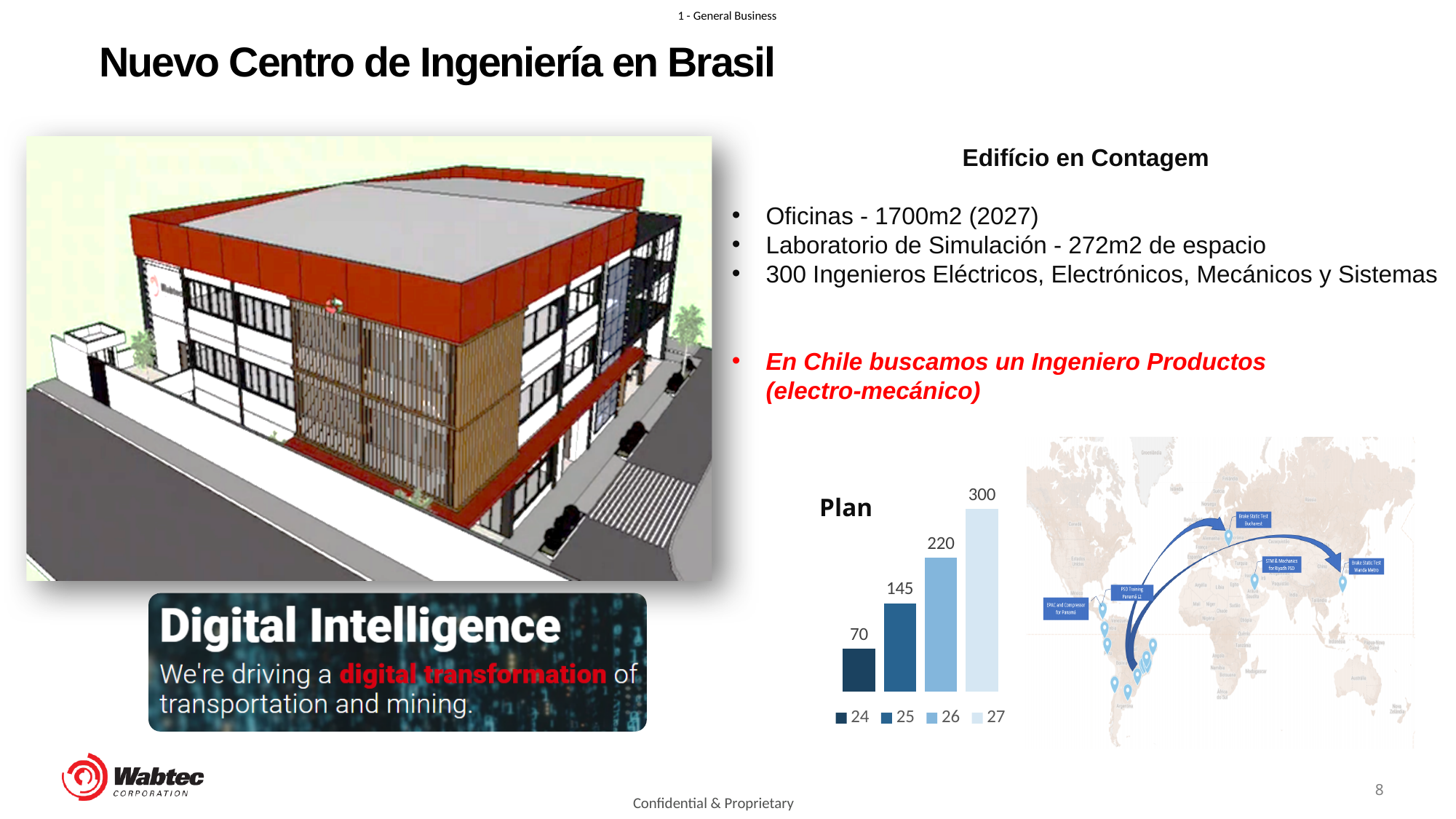
In the "Plan" chart, what is the value for 26? 220 In the "Plan" chart, what is the difference between the values for 27 and 24? 230 In the "Plan" chart, what is the value for 27? 300 In the "Plan" chart, which legend entry has the highest value? 27 In the "Plan" chart, which legend entry has the lowest value? 24 In the "Plan" chart, what is the value for 24? 70 What is the title of the bar chart on the slide? Plan In the "Plan" chart, which is larger, the value for 25 or the value for 26? 26 How many entries does the legend of the "Plan" chart list? 4 In the "Plan" chart, do the values rise or fall from 24 to 27? rise What kind of chart is the "Plan" chart? bar chart In the "Plan" chart, what is the value for 25? 145